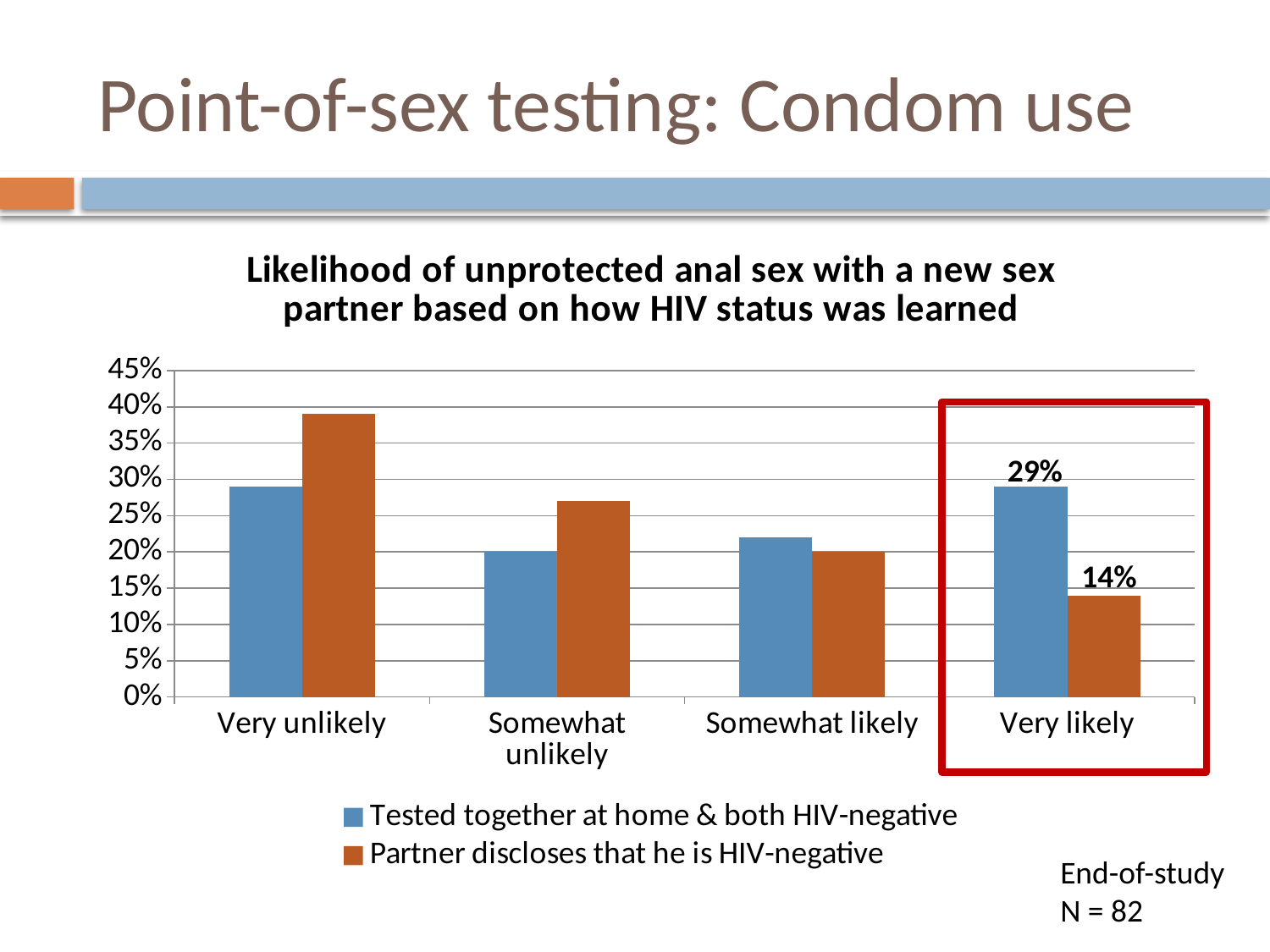
How many categories are shown on the x axis? 4 In the 'Very likely' category, what is the difference between the 'Tested together at home & both HIV-negative' value and the 'Partner discloses that he is HIV-negative' value? 15% Which category on the chart is highlighted with a red box? Very likely What kind of chart is shown on the slide? Bar chart In the 'Very likely' category, which series has the larger value? Tested together at home & both HIV-negative How many series does the legend list? 2 In the 'Very unlikely' category, which series has the larger value? Partner discloses that he is HIV-negative Is the value for 'Partner discloses that he is HIV-negative' in the 'Very unlikely' category greater or less than 35%? greater For the 'Partner discloses that he is HIV-negative' series, which category has the highest value? Very unlikely What is the value for 'Tested together at home & both HIV-negative' in the 'Very likely' category? 29% What is the value for 'Partner discloses that he is HIV-negative' in the 'Very likely' category? 14% For the 'Partner discloses that he is HIV-negative' series, which category has the lowest value? Very likely